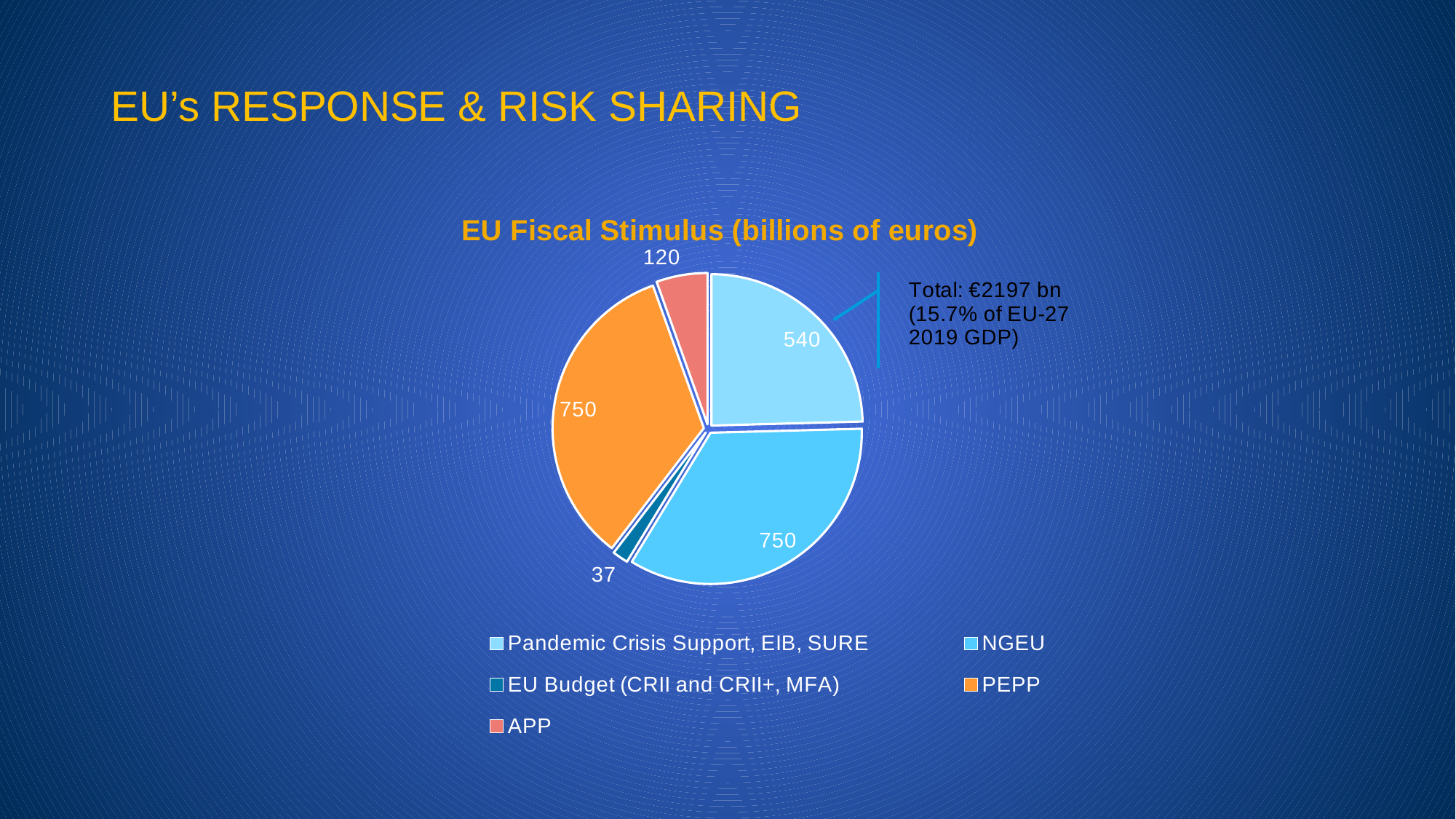
What is the difference between the APP value and the EU Budget (CRII and CRII+, MFA) value? 83 What is the difference between the PEPP value and the Pandemic Crisis Support, EIB, SURE value? 210 What is the title of the pie chart? EU Fiscal Stimulus (billions of euros) Which category has the smallest slice in the pie chart? EU Budget (CRII and CRII+, MFA) What colour is the PEPP slice in the pie chart? Orange What is the value for NGEU in the EU Fiscal Stimulus chart? 750 What is the value for APP? 120 What is the value for Pandemic Crisis Support, EIB, SURE? 540 What type of chart is shown on the slide? Pie chart What is the value for EU Budget (CRII and CRII+, MFA)? 37 How many slices does the pie chart have? 5 Which is larger, the value for APP or the value for Pandemic Crisis Support, EIB, SURE? Pandemic Crisis Support, EIB, SURE